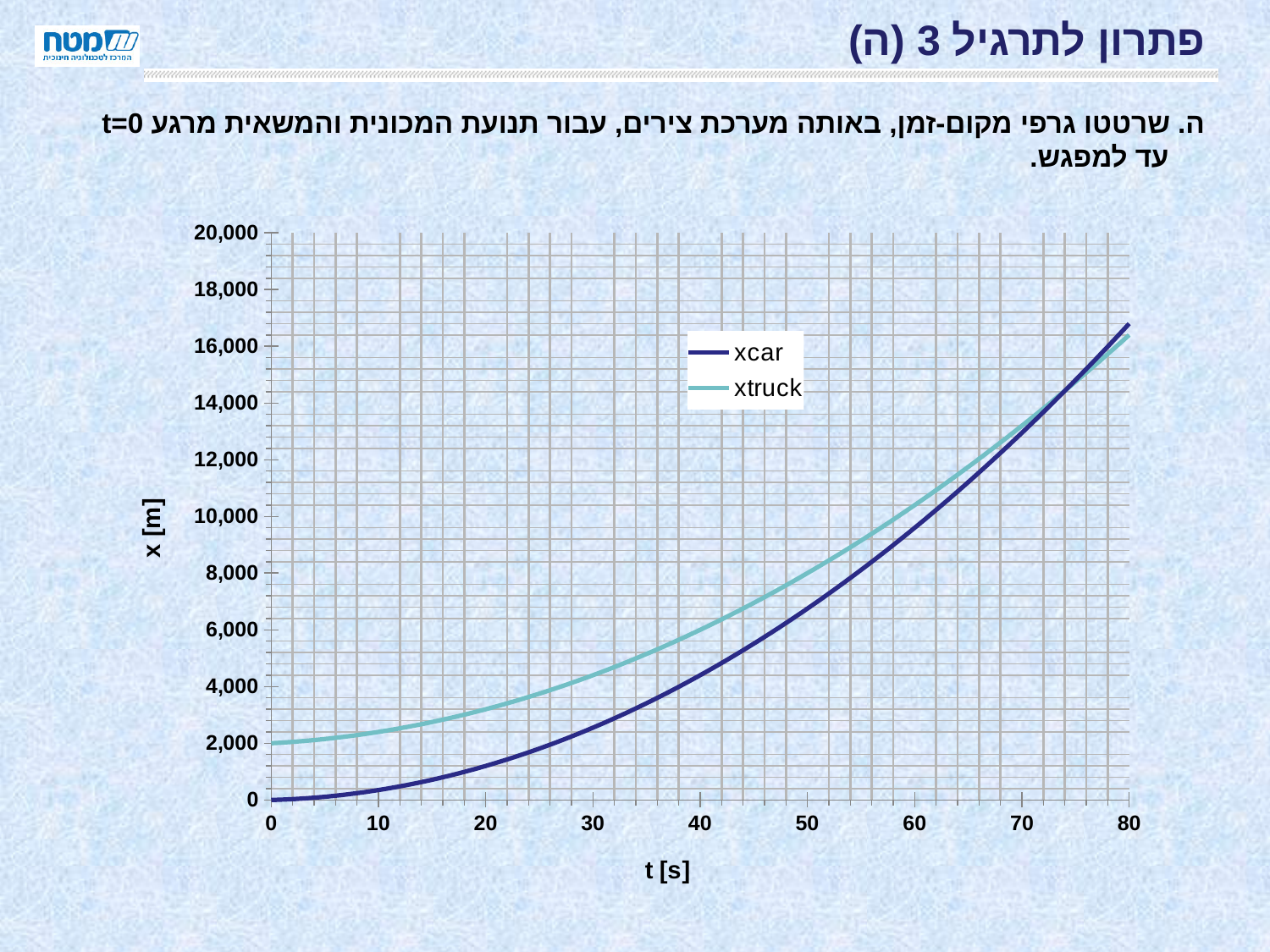
What is the value of xtruck at t = 0? 2,000 What kind of chart is shown on the slide? line chart Is the value of xcar at t = 80 greater or less than 18,000? less What are the two series named in the legend? xcar and xtruck At t = 40, which series has the larger value, xcar or xtruck? xtruck What is the label of the horizontal axis? t [s] Do the values of xcar rise or fall as t increases? rise How many series does the legend list? 2 Is the value of xtruck at t = 40 greater or less than 4,000? greater What is the value of xcar at t = 0? 0 Is the value of xcar at t = 60 greater or less than 8,000? greater Do the values of xtruck rise or fall as t increases? rise